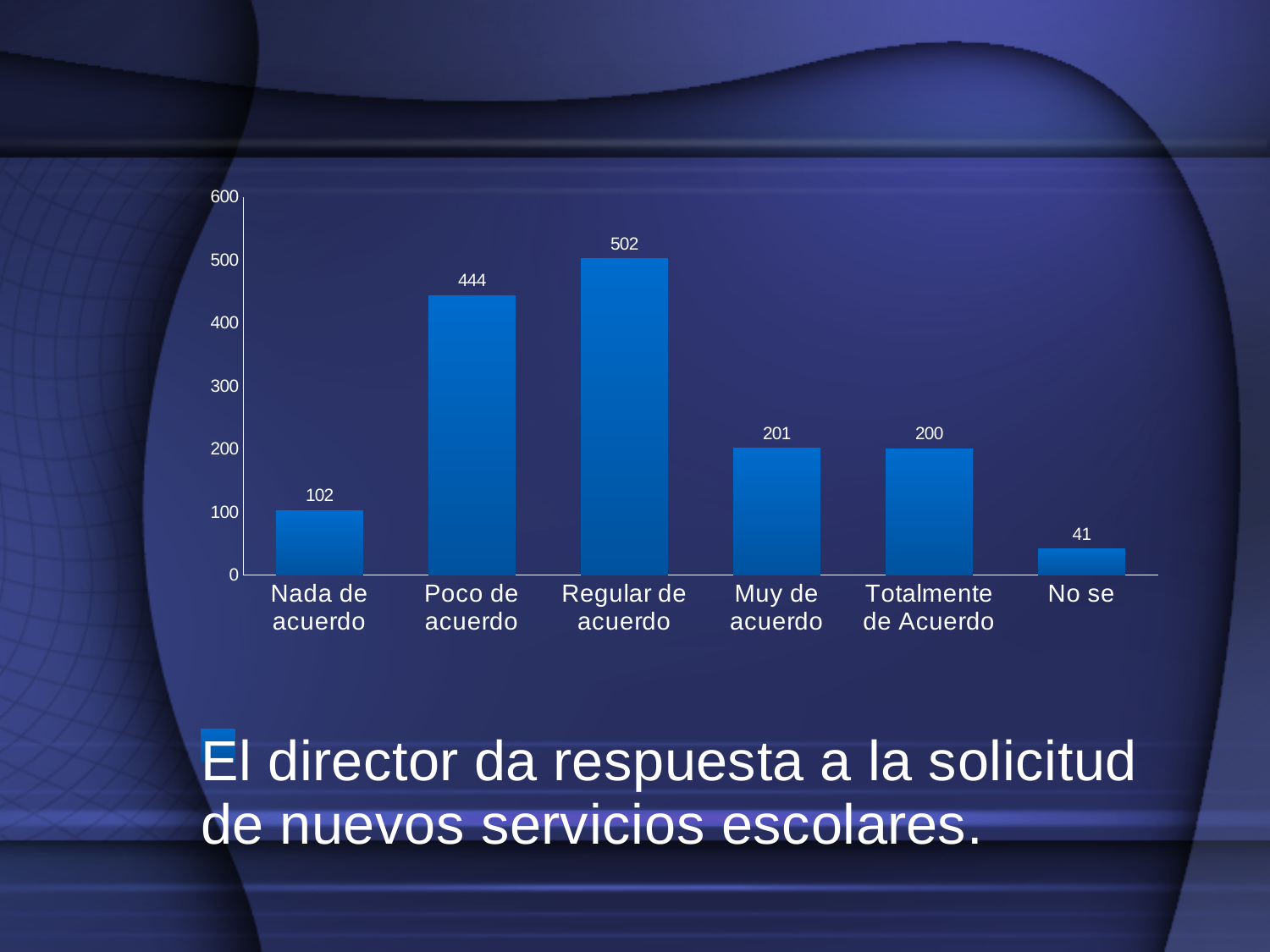
Which is larger, the value for "Poco de acuerdo" or the value for "Muy de acuerdo"? Poco de acuerdo What is the value for "No se"? 41 What kind of chart is shown on the slide? bar chart What is the value for "Nada de acuerdo"? 102 What is the difference between the values for "Regular de acuerdo" and "Poco de acuerdo"? 58 Is the value for "Poco de acuerdo" greater or less than 400? greater How many categories are shown on the x axis? 6 Which category has the highest value? Regular de acuerdo What is the difference between the values for "Muy de acuerdo" and "No se"? 160 What is the text shown below the chart? El director da respuesta a la solicitud de nuevos servicios escolares. What is the value for "Regular de acuerdo"? 502 Which category has the lowest value? No se